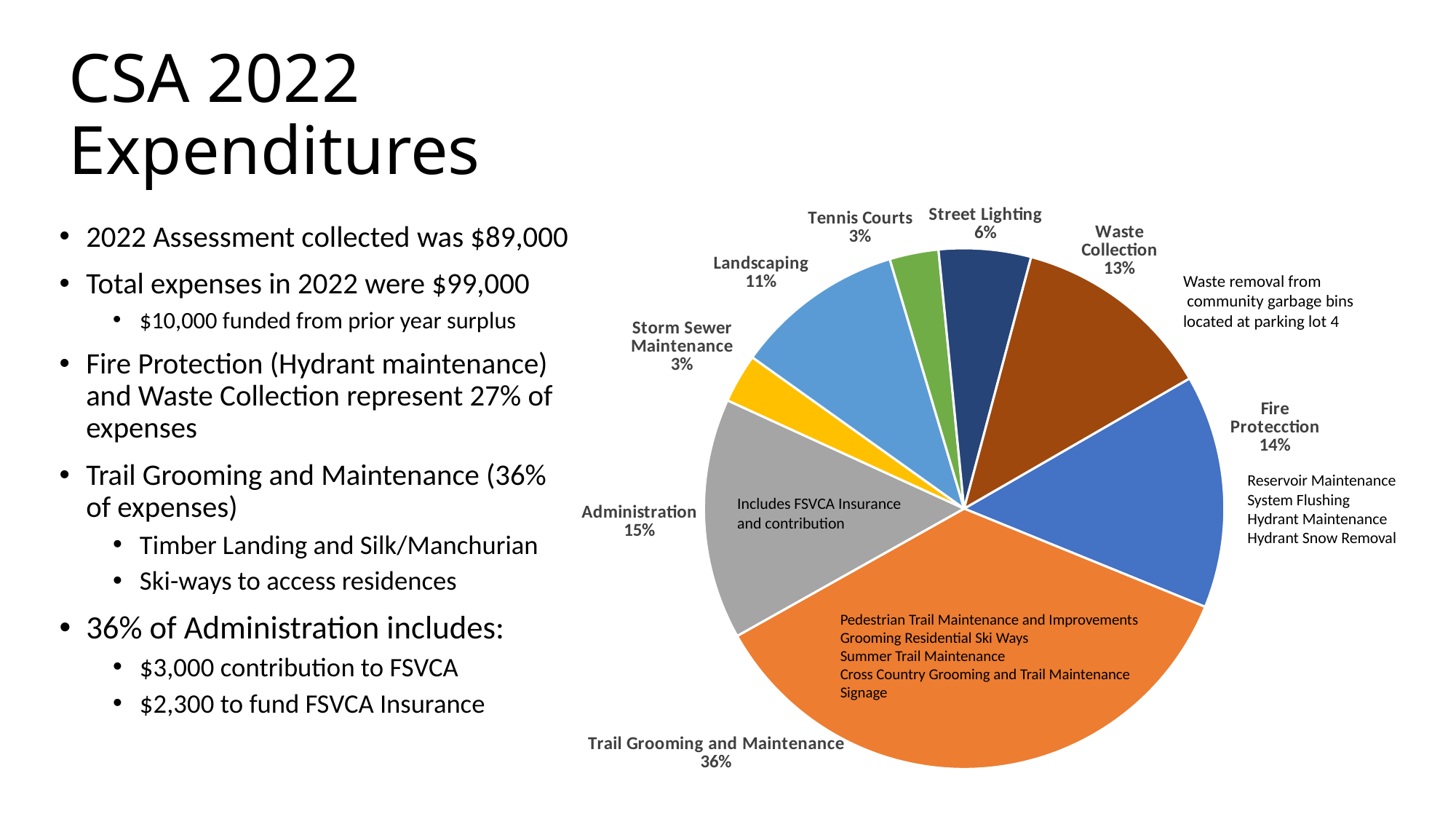
What is the difference in percentage points between Administration and Waste Collection? 2 What percentage of expenditures is Waste Collection? 13% What colour is the Trail Grooming and Maintenance slice? Orange What percentage of expenditures is Fire Protection? 14% Which is larger, Fire Protection or Landscaping? Fire Protection Which category has the largest share of expenditures? Trail Grooming and Maintenance What percentage of expenditures is Landscaping? 11% What share of expenditures does Trail Grooming and Maintenance represent? 36% How many categories are shown in the pie chart? 8 What kind of chart is shown on the slide? Pie chart What percentage of expenditures is Administration? 15% What percentage of expenditures is Street Lighting? 6%